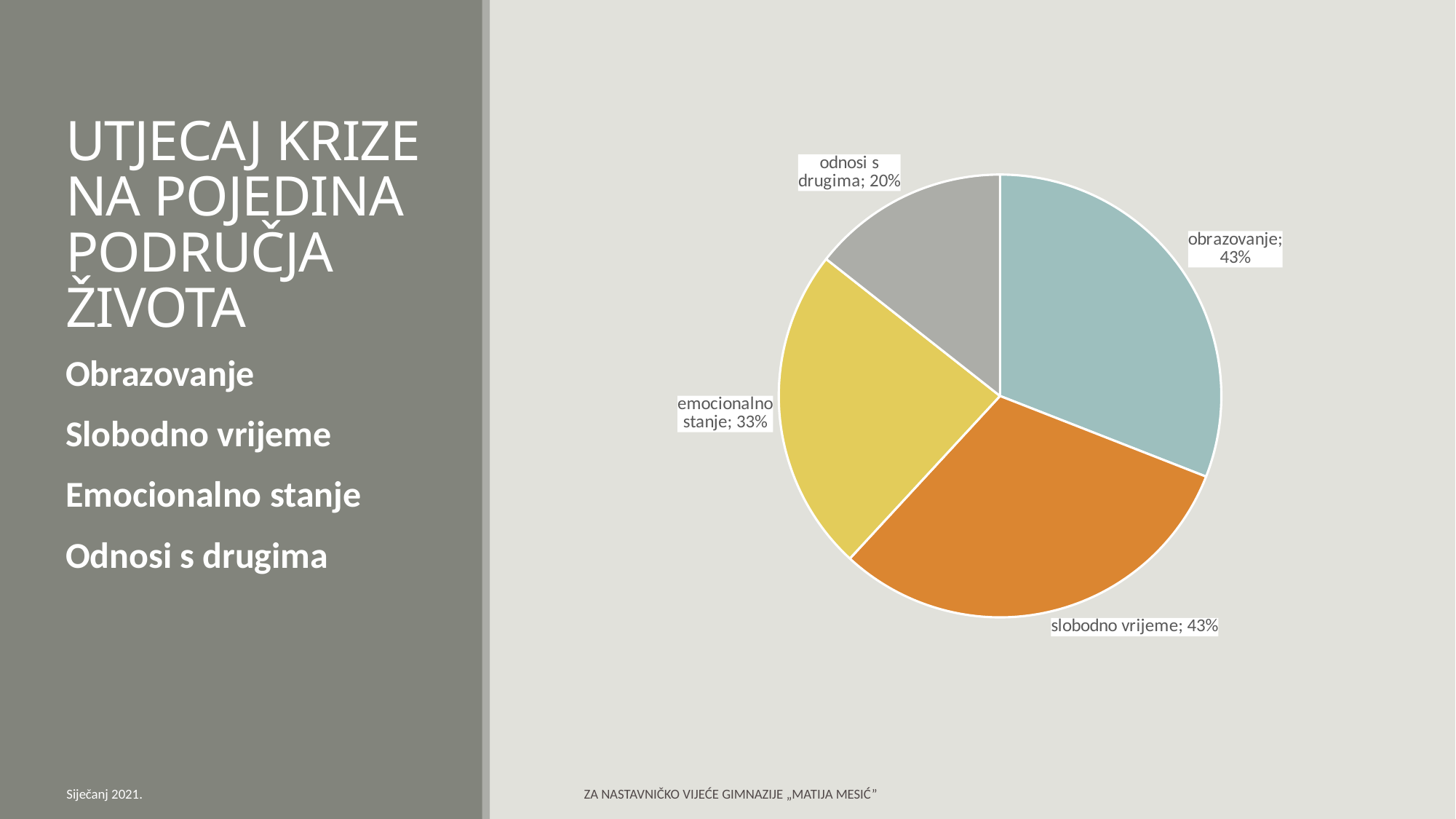
What percentage is shown for emocionalno stanje in the pie chart? 33% How many slices does the pie chart have? 4 What percentage is shown for odnosi s drugima in the pie chart? 20% What kind of chart is shown on the slide? pie chart What is the difference in percentage points between obrazovanje and odnosi s drugima? 23 Which is larger in the pie chart, emocionalno stanje or odnosi s drugima? emocionalno stanje What colour is the slobodno vrijeme slice in the pie chart? orange Which category has the smallest slice in the pie chart? odnosi s drugima What colour is the odnosi s drugima slice in the pie chart? grey What percentage is shown for slobodno vrijeme in the pie chart? 43% What is the difference in percentage points between slobodno vrijeme and emocionalno stanje? 10 What percentage is shown for obrazovanje in the pie chart? 43%